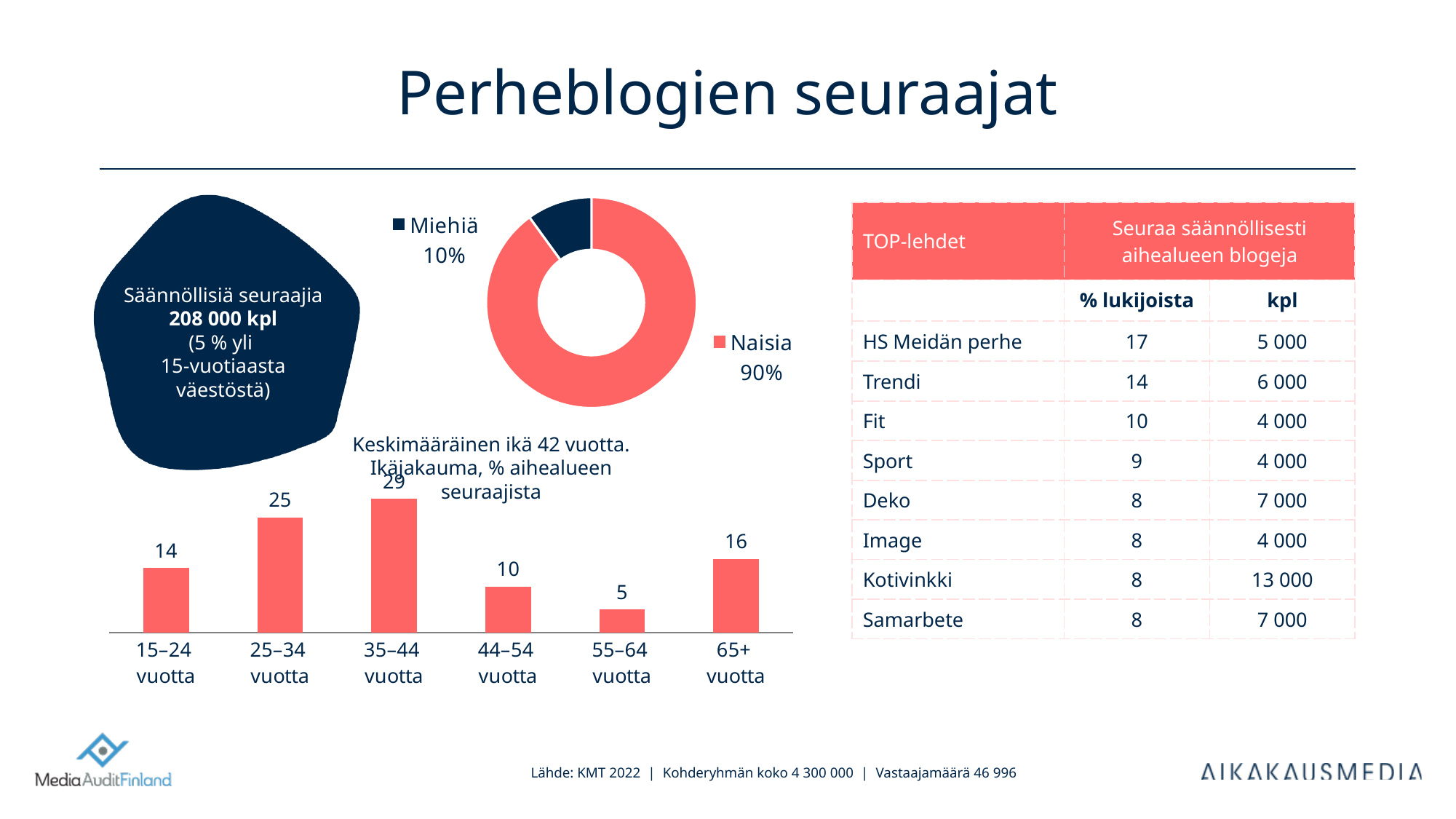
In the age distribution bar chart, which age group has the highest value? 35–44 vuotta In the age distribution bar chart, what is the difference between the values for 25–34 vuotta and 15–24 vuotta? 11 In the age distribution bar chart, what is the value for 35–44 vuotta? 29 In the age distribution bar chart, which age group has the lowest value? 55–64 vuotta In the donut chart, what share of family blog followers are men (Miehiä)? 10% What kind of chart is used to show the age distribution (Ikäjakauma)? Bar chart How many series does the legend of the donut chart list? 2 In the age distribution bar chart, which is larger: the value for 65+ vuotta or the value for 44–54 vuotta? 65+ vuotta In the age distribution bar chart, what is the value for 55–64 vuotta? 5 What kind of chart shows the split between Miehiä and Naisia? Donut chart In the donut chart, what share of family blog followers are women (Naisia)? 90% How many age groups are shown in the age distribution bar chart? 6